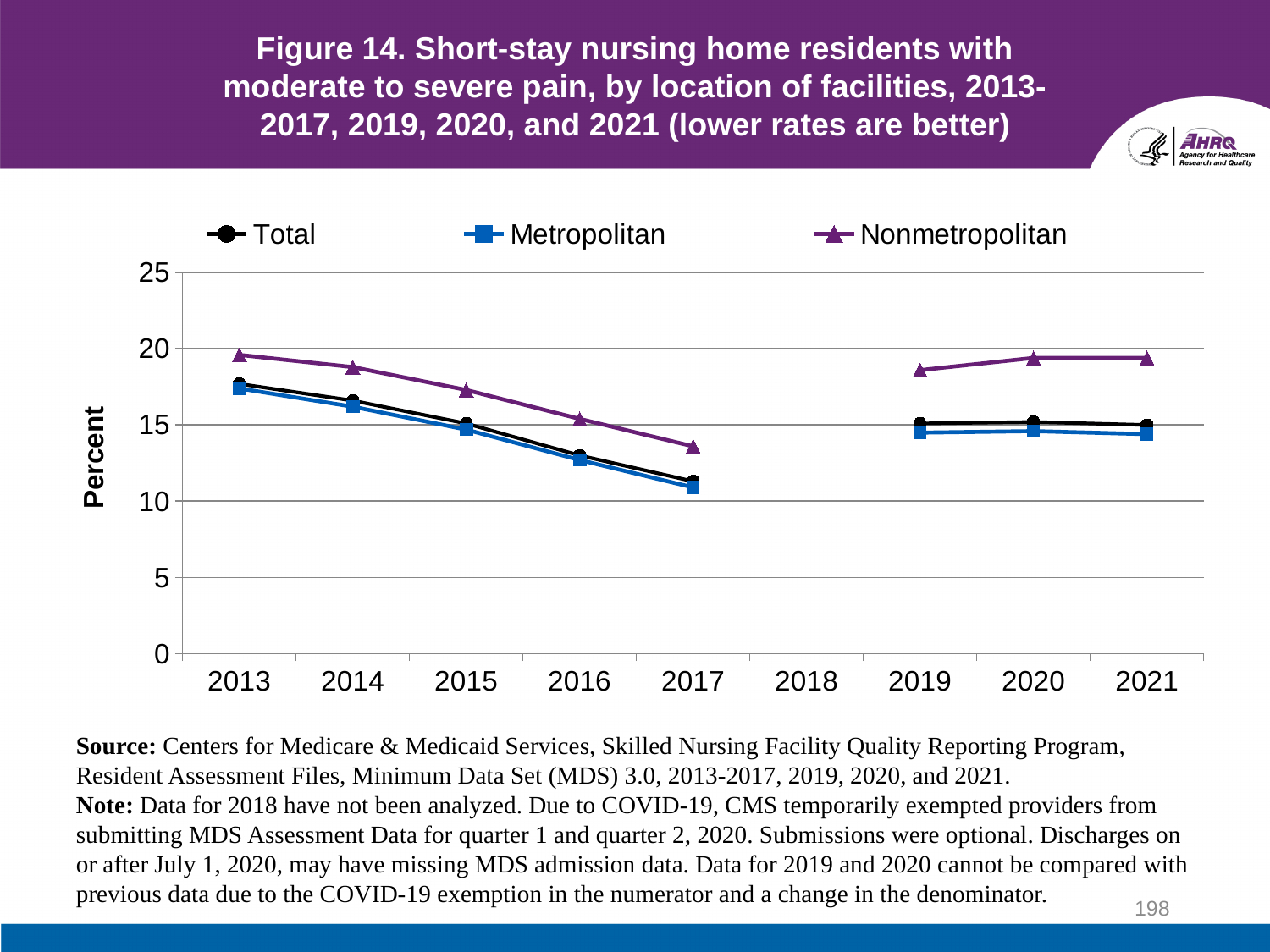
How many series does the legend list? 3 Which series has the highest value in 2017? Nonmetropolitan Which year on the x axis has no data plotted? 2018 Is the value for Nonmetropolitan in 2013 greater or less than 20? less Is the value for Total in 2019 greater or less than 10? greater Is the value for Metropolitan in 2016 greater or less than 15? less How many years have data points plotted for each series? 8 Do the Nonmetropolitan values rise or fall from 2013 to 2017? fall What kind of chart is shown on the slide? line chart Which series has the lowest value in 2013? Metropolitan In which year is the Total series at its lowest? 2017